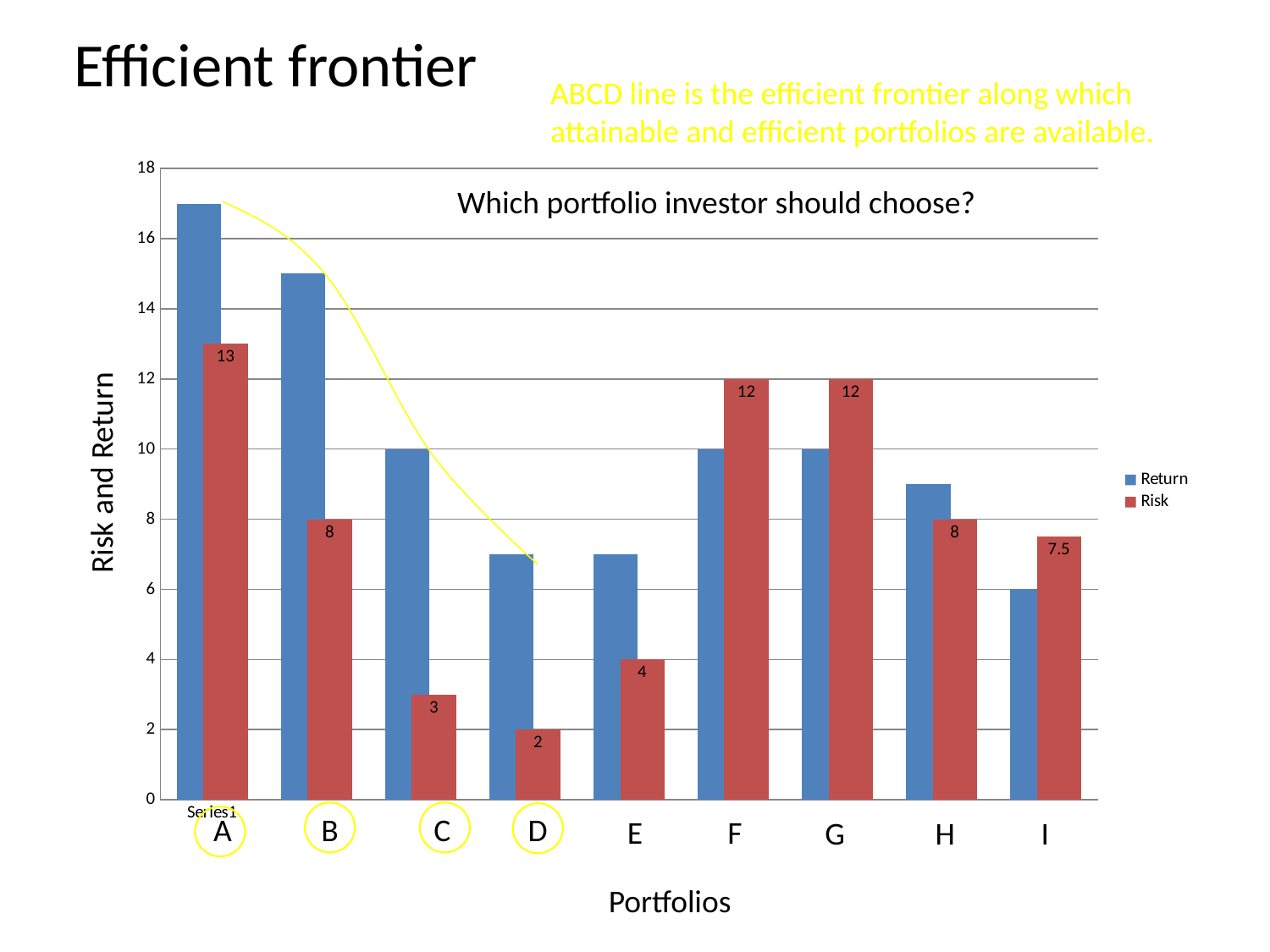
Which is larger, the Risk value for portfolio F or the Risk value for portfolio E? F How many series does the legend list? 2 What kind of chart is shown on the slide? bar chart Is the Return value for portfolio D greater or less than 8? less Which portfolio has the lowest Risk value? D Is the Return value for portfolio B greater or less than 14? greater What is the Return value for portfolio I? 6 What is the difference between the Risk values of portfolio A and portfolio C? 10 Which portfolio has the highest Return value? A What is the Risk value for portfolio I? 7.5 What is the Risk value for portfolio A? 13 How many portfolios are shown on the x axis? 9